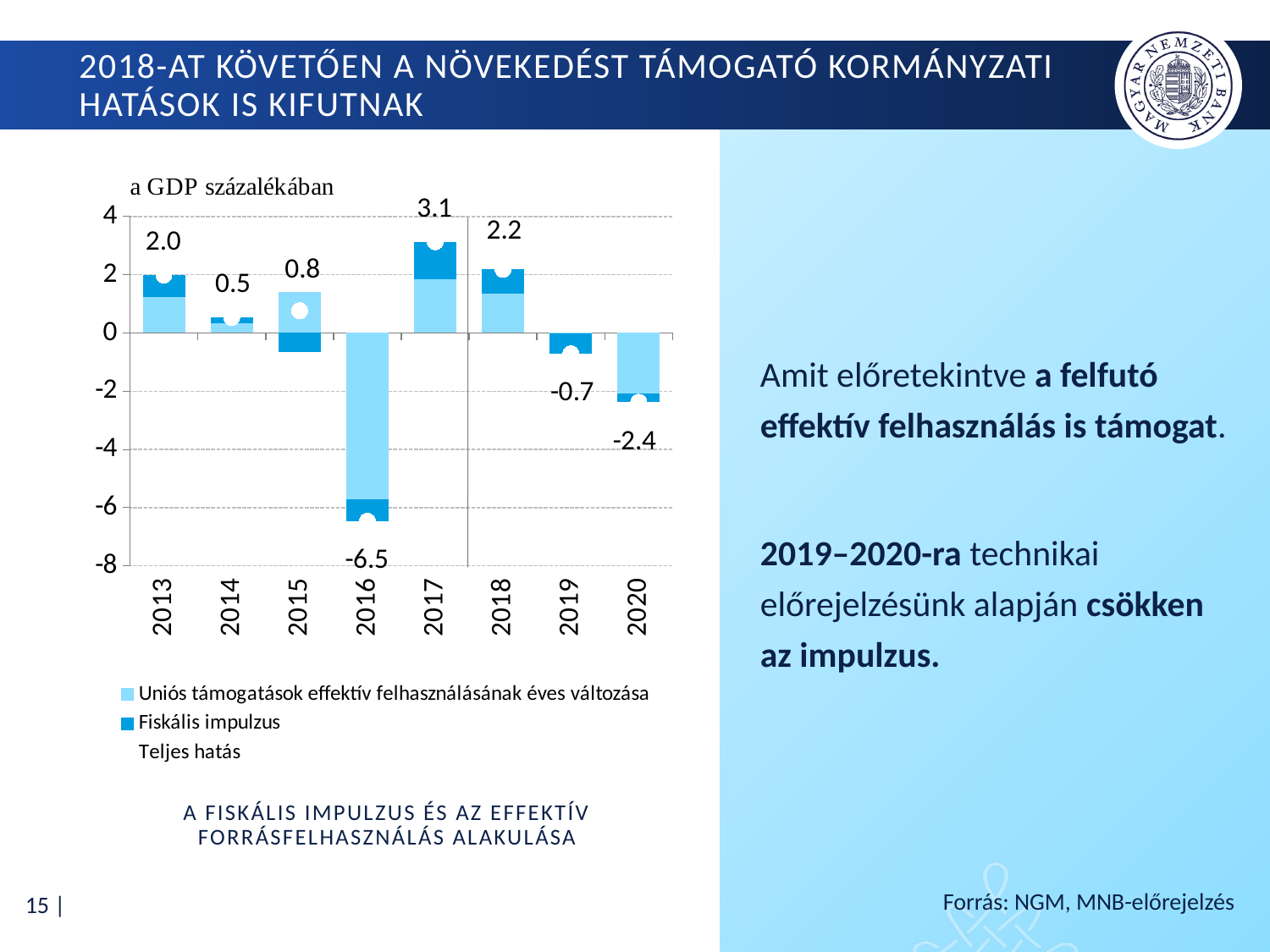
What is the Teljes hatás value for 2016? -6.5 What is the Teljes hatás value for 2020? -2.4 How many entries does the chart legend list? 3 Which year has the highest Teljes hatás value? 2017 What is the difference between the Teljes hatás values for 2013 and 2014? 1.5 What unit is given above the chart's y axis? a GDP százalékában Which year has the lowest Teljes hatás value? 2016 Which year has a larger Teljes hatás value, 2018 or 2019? 2018 What is the difference between the Teljes hatás values for 2017 and 2018? 0.9 What is the Teljes hatás value for 2017? 3.1 Is the value of Uniós támogatások effektív felhasználásának éves változása for 2016 greater or less than -4? less How many years are shown on the x axis of the chart? 8